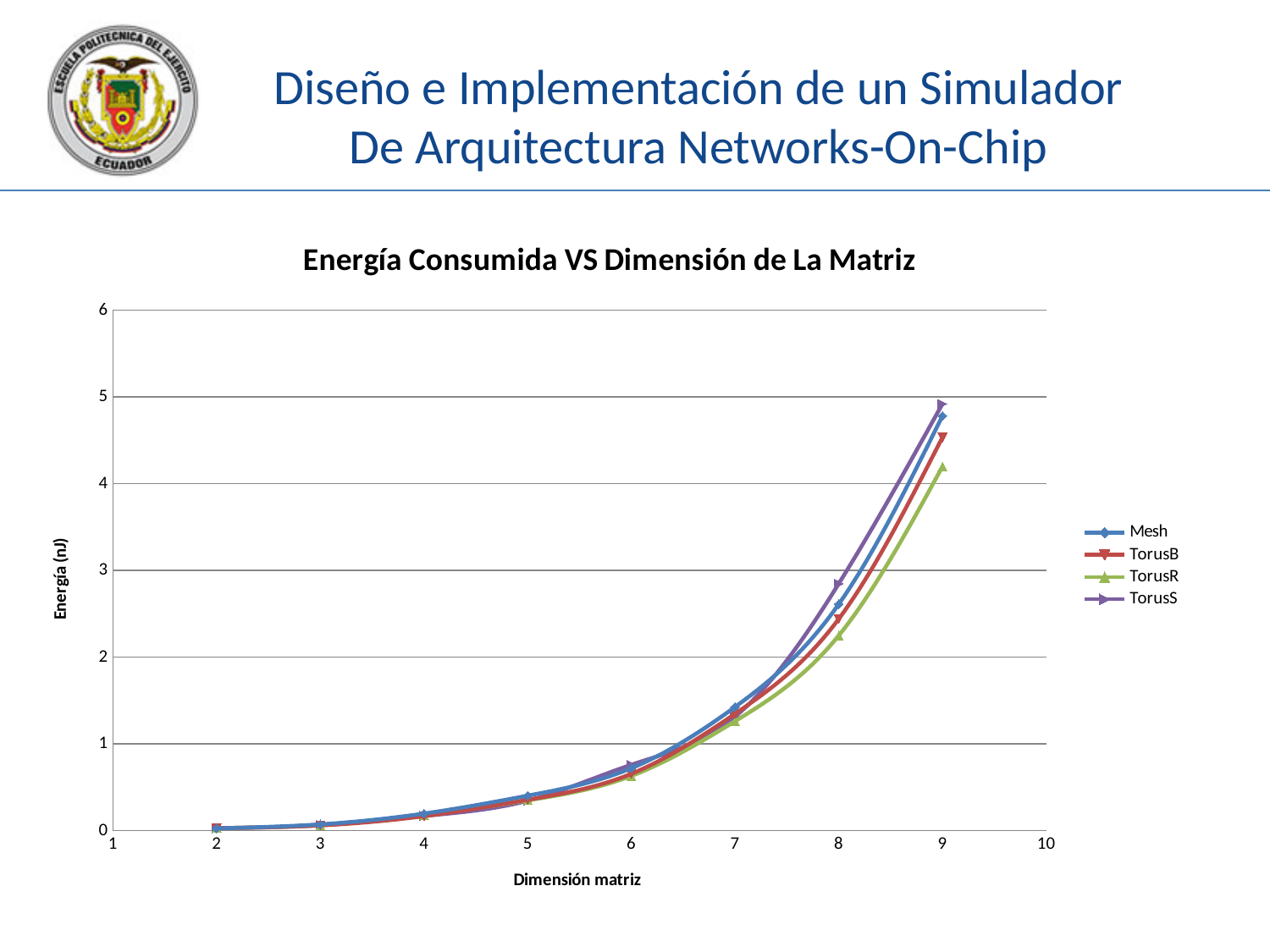
Which series has the lowest energy value at matrix dimension 9? TorusR At matrix dimension 9, which is larger, the value for Mesh or the value for TorusR? Mesh What is the label of the vertical axis? Energía (nJ) Which series has the highest energy value at matrix dimension 9? TorusS Is the value for TorusS at matrix dimension 9 greater or less than 5? less Is the value for Mesh at matrix dimension 8 greater or less than 2? greater Is the value for Mesh at matrix dimension 6 greater or less than 1? less How many series does the legend list? 4 What kind of chart is shown on the slide? line chart What is the title of the chart? Energía Consumida VS Dimensión de La Matriz Do the energy values rise or fall as the matrix dimension increases? rise